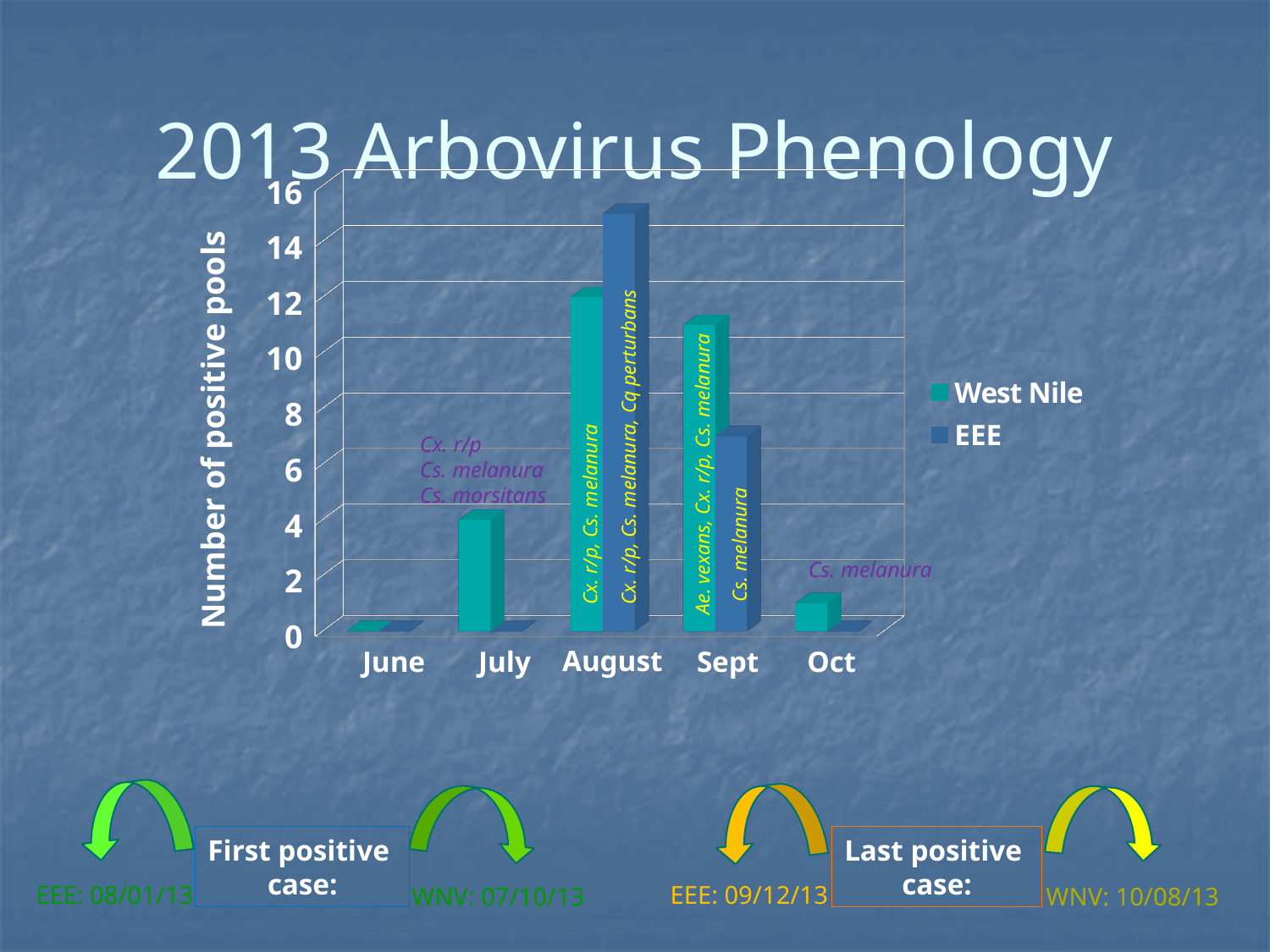
How many months are shown on the x axis? 5 In August, which series has the larger value, West Nile or EEE? EEE In which month is the EEE value highest? August Is the EEE value for Sept greater or less than 8? less Is the West Nile value for Sept greater or less than 10? greater What kind of chart is shown on the slide? bar chart What is the title of the y axis? Number of positive pools In Sept, which series has the larger value, West Nile or EEE? West Nile How many series does the legend list? 2 In which month is the West Nile value highest? August What is the West Nile value for July? 4 Is the EEE value for August greater or less than 14? greater